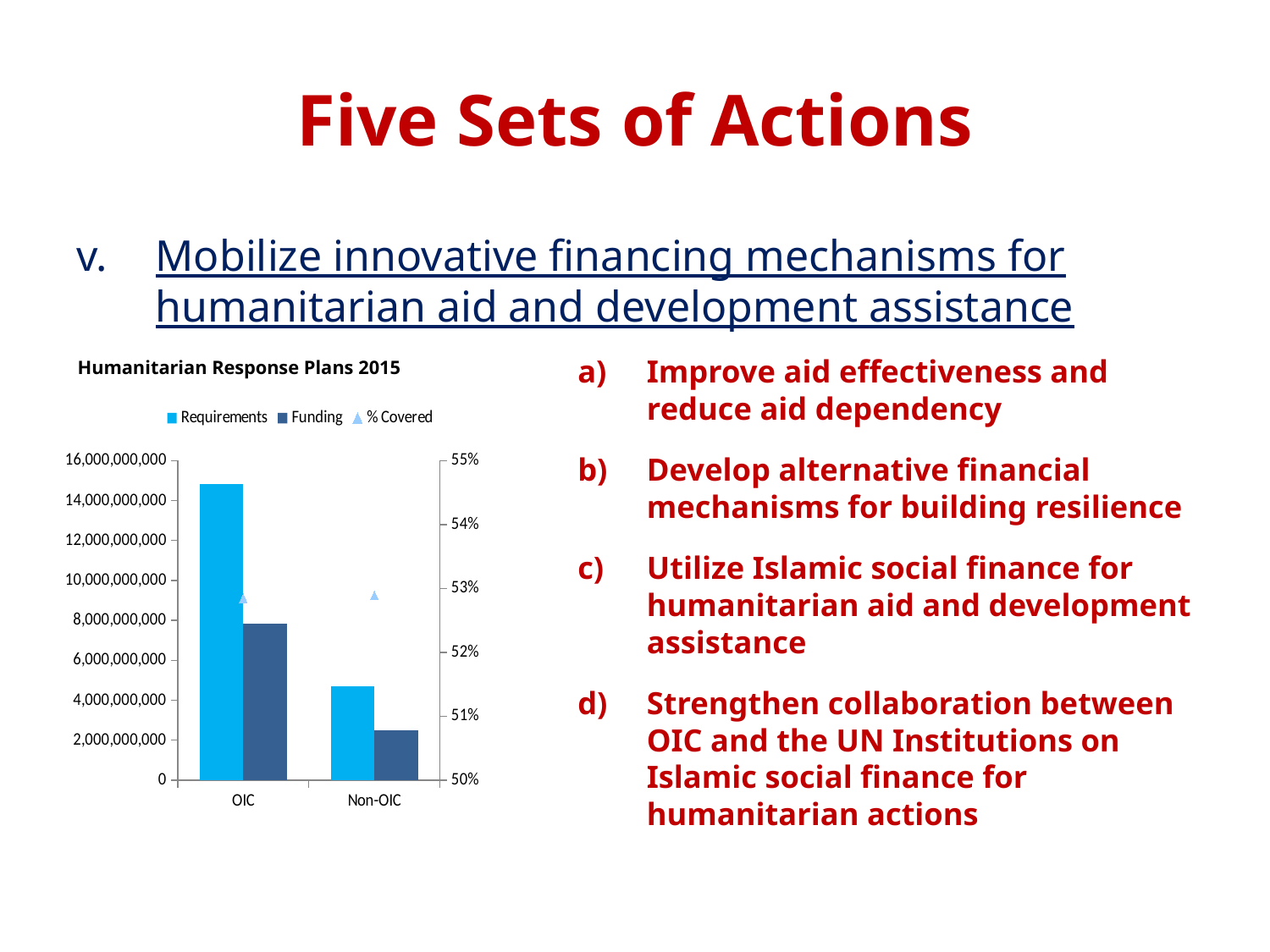
Is the Requirements value for Non-OIC greater or less than 4,000,000,000? greater Which category has the higher Requirements value, OIC or Non-OIC? OIC What is the title of the chart? Humanitarian Response Plans 2015 Which series in the legend is plotted with triangle markers? % Covered What kind of chart is shown on the slide? Bar chart Is the % Covered value for OIC greater or less than 52%? greater How many series does the chart legend list? 3 Is the Funding value for Non-OIC greater or less than 2,000,000,000? greater How many categories are shown on the x axis of the chart? 2 Which category has the lowest Funding value? Non-OIC